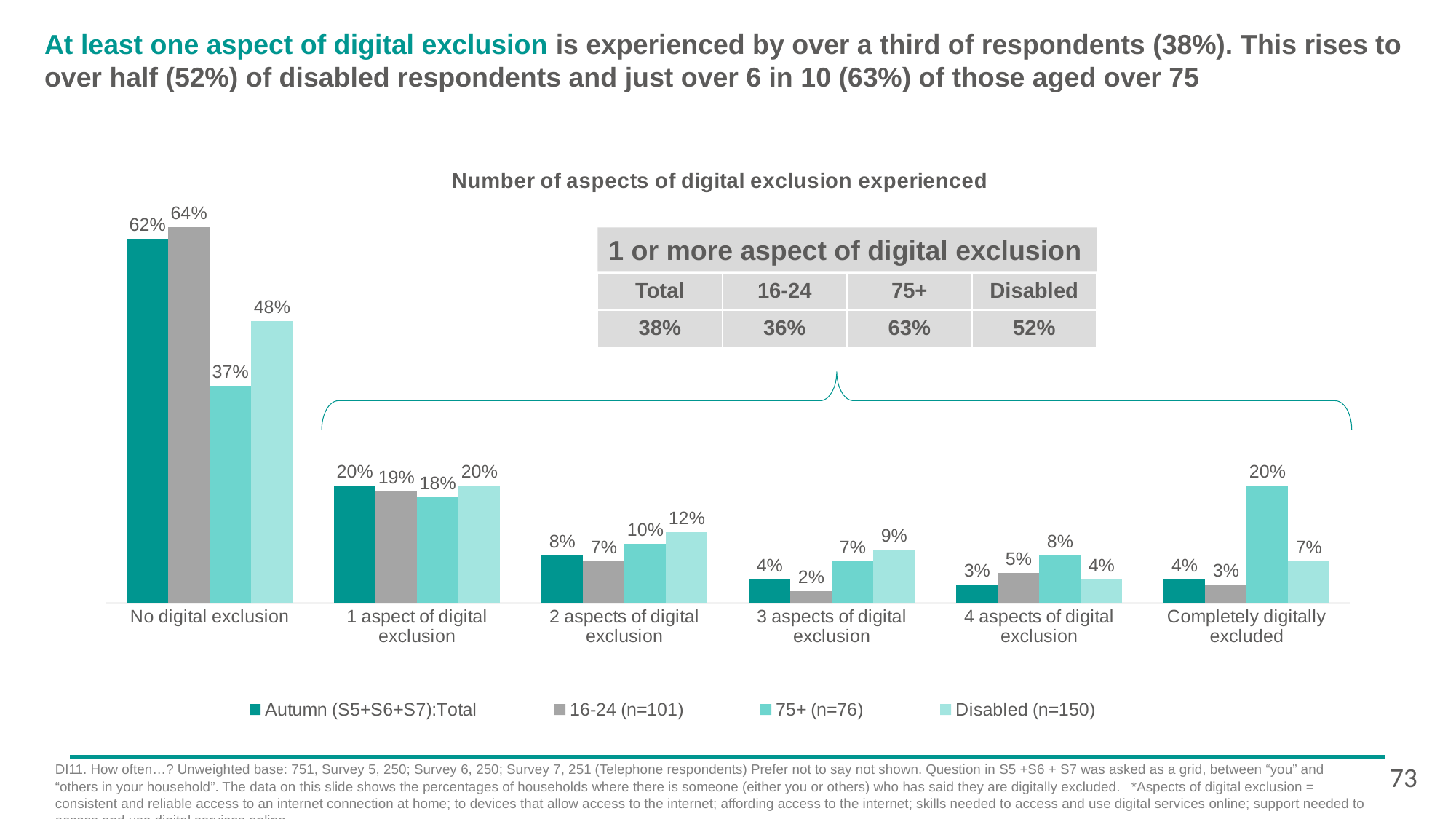
What is the difference between the 16-24 (n=101) and 75+ (n=76) values for 'No digital exclusion'? 27% How many categories are shown on the x axis of the chart? 6 How many series does the legend list? 4 What kind of chart is shown on the slide? Bar chart Which category has the highest value in the Autumn (S5+S6+S7):Total series? No digital exclusion Which series has the lowest value for 'No digital exclusion'? 75+ (n=76) What is the value for '3 aspects of digital exclusion' in the 16-24 (n=101) series? 2% What is the value for 'Completely digitally excluded' in the 75+ (n=76) series? 20% Which is larger for 'Completely digitally excluded': the 75+ (n=76) value or the Disabled (n=150) value? 75+ (n=76) What is the value for '2 aspects of digital exclusion' in the Disabled (n=150) series? 12% What is the value for 'No digital exclusion' in the 75+ (n=76) series? 37% What is the title of the chart? Number of aspects of digital exclusion experienced